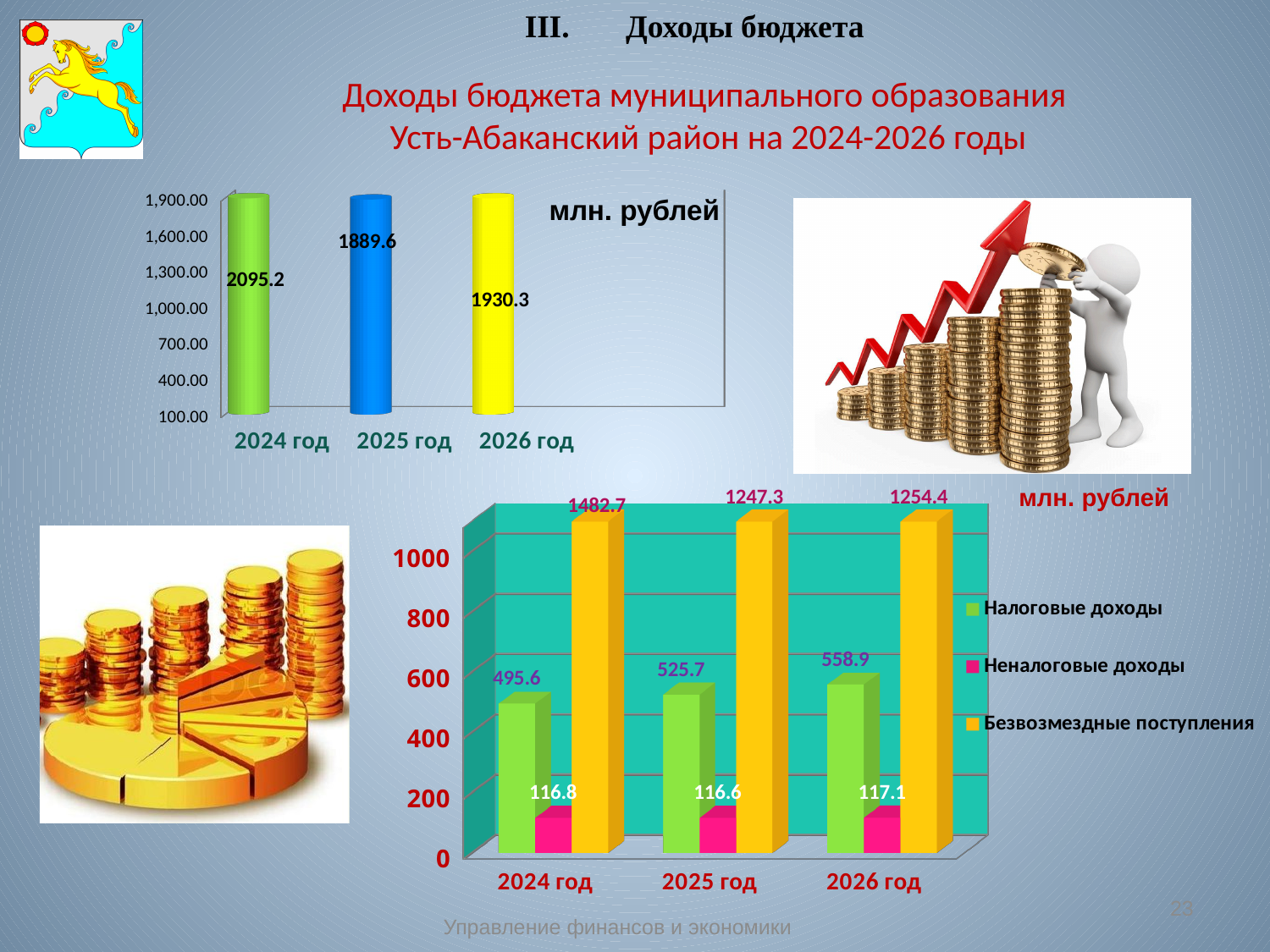
In the top chart, what is the value for 2024 год? 2095.2 In the top chart, what is the value for 2025 год? 1889.6 In the bottom chart, which year has the highest value for Безвозмездные поступления? 2024 год How many categories are shown on the x axis of the top chart? 3 In the top chart, which year has the lowest value? 2025 год What kind of chart is the bottom chart? bar chart In the bottom chart, what is the value of Неналоговые доходы for 2024 год? 116.8 In the bottom chart, do the values of Налоговые доходы rise or fall from 2024 год to 2026 год? rise In the top chart, what is the difference between the values for 2024 год and 2026 год? 164.9 In the bottom chart, what is the value of Безвозмездные поступления for 2025 год? 1247.3 How many series does the legend of the bottom chart list? 3 In the bottom chart, what is the value of Налоговые доходы for 2026 год? 558.9